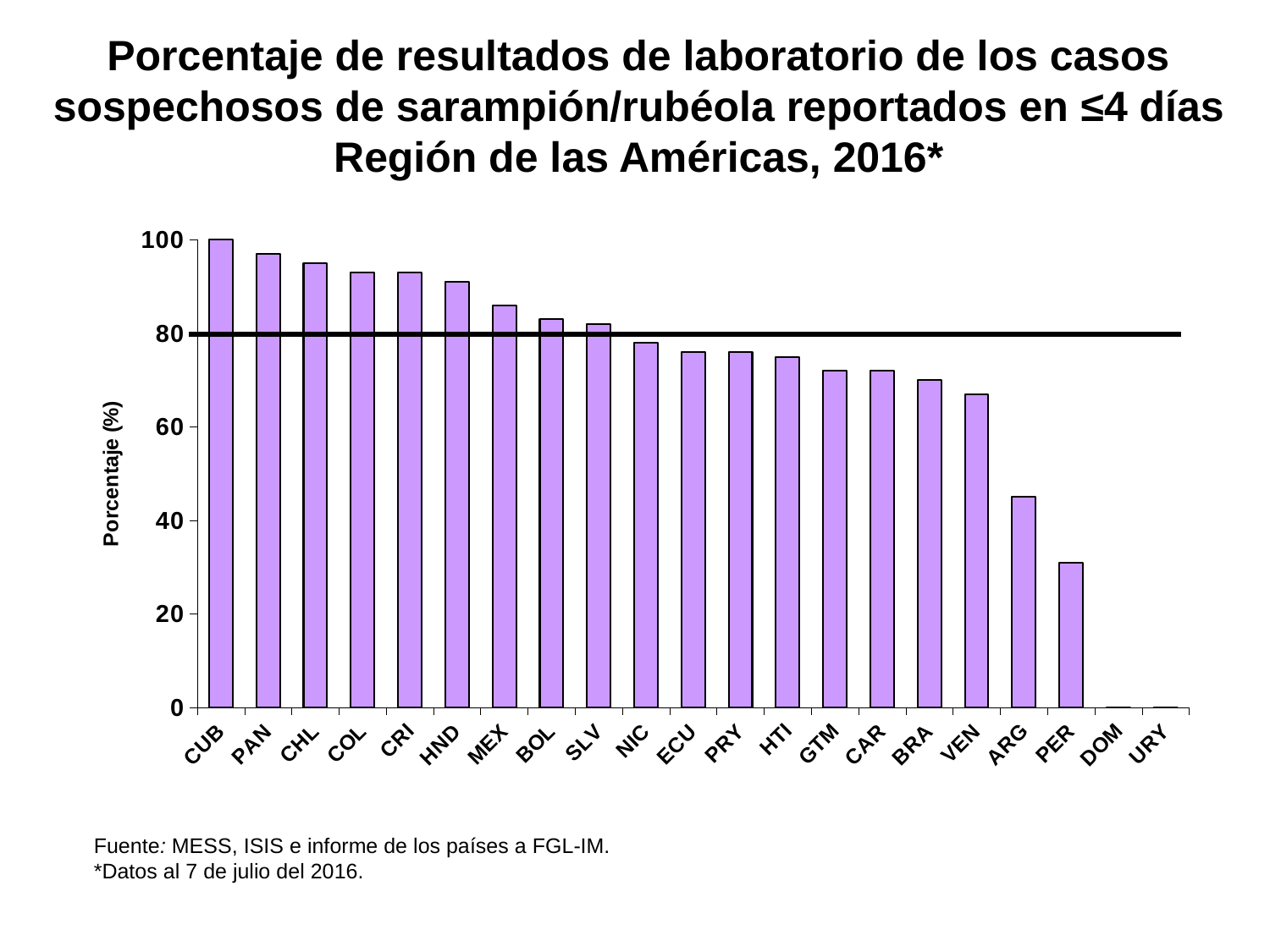
Which is larger, the value for ARG or the value for PER? ARG What kind of chart is shown on the slide? bar chart Which country has the highest percentage in the chart? CUB How many countries are shown on the x axis of the chart? 21 Is the value for HND greater or less than 80? greater Is the value for PER greater or less than 40? less What is the value for CUB? 100 What is the label of the vertical axis? Porcentaje (%) Is the value for PAN greater or less than 80? greater Do the values rise or fall moving from left to right along the x axis? fall